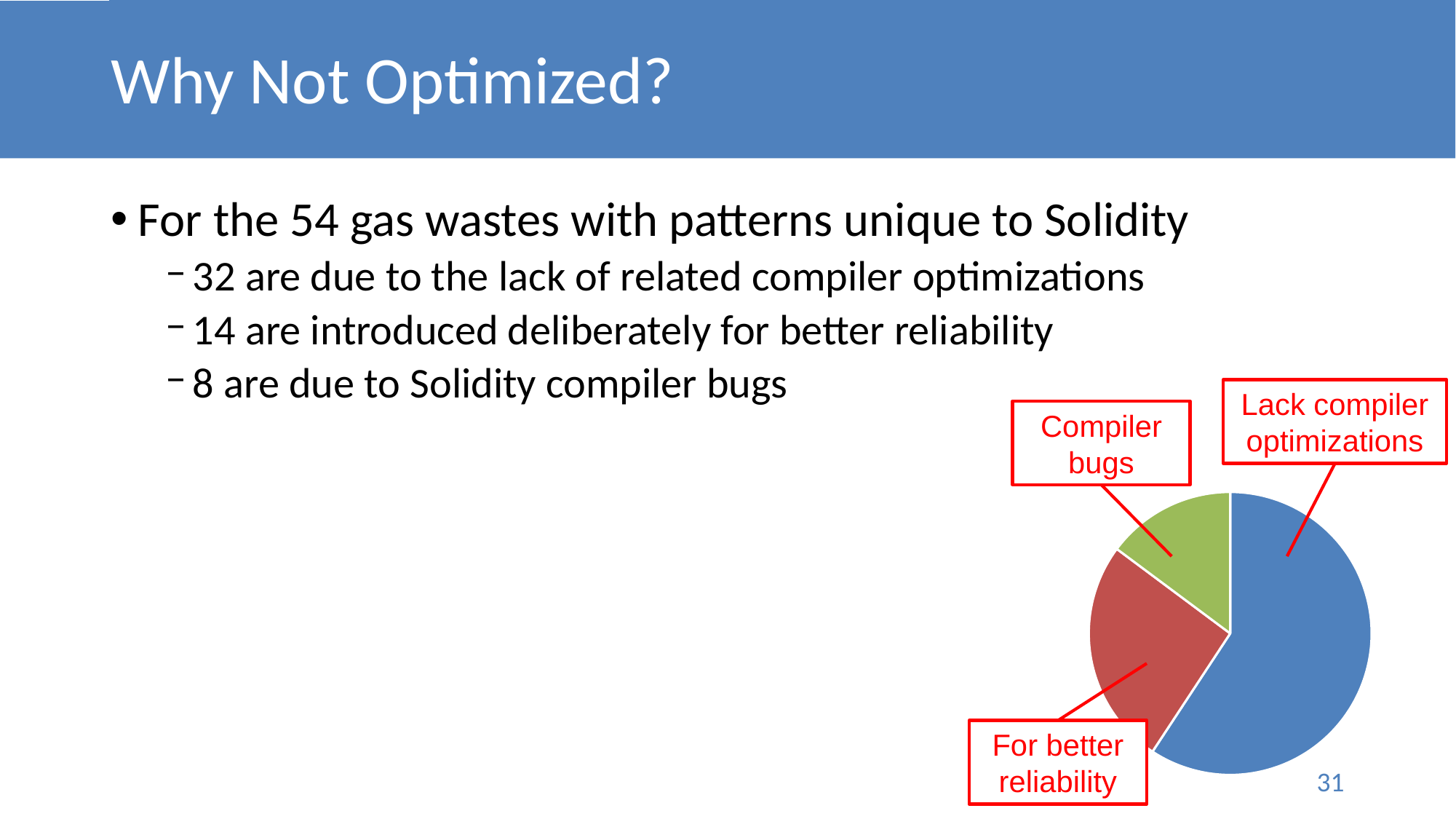
According to the slide, how many gas wastes fall in the For better reliability slice? 14 Which slice is larger, Lack compiler optimizations or For better reliability? Lack compiler optimizations What colour is the Lack compiler optimizations slice? blue Which slice of the pie chart is the largest? Lack compiler optimizations According to the slide, how many gas wastes fall in the Compiler bugs slice? 8 Which slice is larger, For better reliability or Compiler bugs? For better reliability What is the difference between the Lack compiler optimizations count and the For better reliability count? 18 Which slice of the pie chart is the smallest? Compiler bugs How many slices does the pie chart have? 3 What kind of chart is shown on the slide? pie chart What colour is the Compiler bugs slice? green According to the slide, how many gas wastes fall in the Lack compiler optimizations slice? 32